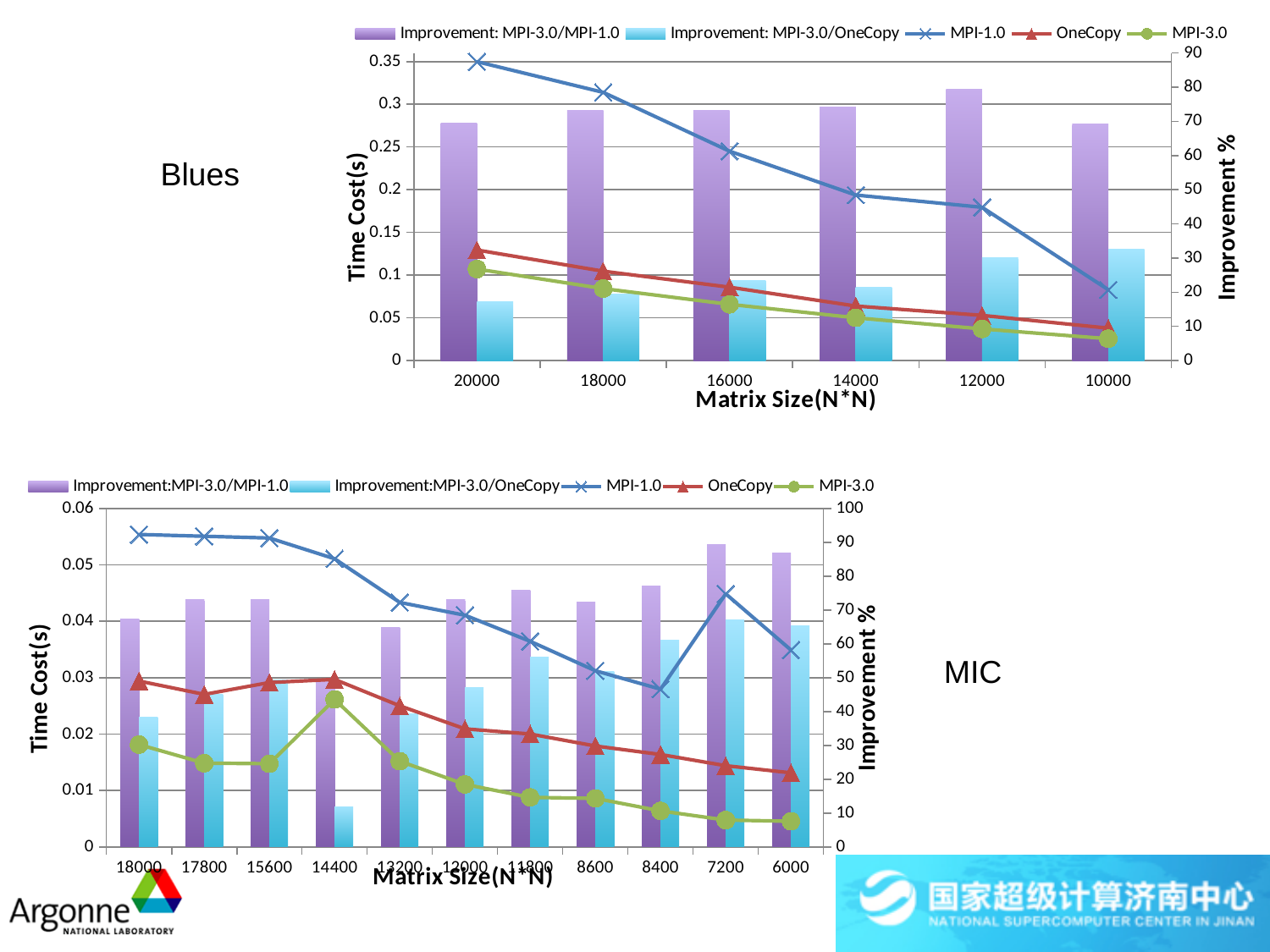
On the Blues chart, is the MPI-3.0 time cost at matrix size 10000 greater or less than 0.05? less On the MIC chart, is the MPI-3.0 time cost at matrix size 6000 greater or less than 0.01? less On the MIC chart, at which matrix size is the Improvement:MPI-3.0/OneCopy bar lowest? 14400 What kind of chart is the MIC chart? Combined bar and line chart On the Blues chart, does the MPI-1.0 time cost rise or fall as you move from 20000 to 10000 along the x axis? Fall On the Blues chart, at which matrix size is the Improvement: MPI-3.0/OneCopy bar lowest? 20000 On the MIC chart, at matrix size 18000, which has the larger time cost: MPI-1.0 or OneCopy? MPI-1.0 On the Blues chart, is the MPI-1.0 time cost at matrix size 20000 greater or less than 0.3? greater On the MIC chart, how many matrix sizes are shown on the x axis? 11 On the Blues chart, how many series does the legend list? 5 On the Blues chart, at which matrix size is the MPI-1.0 time cost highest? 20000 On the Blues chart, how many matrix sizes are shown on the x axis? 6